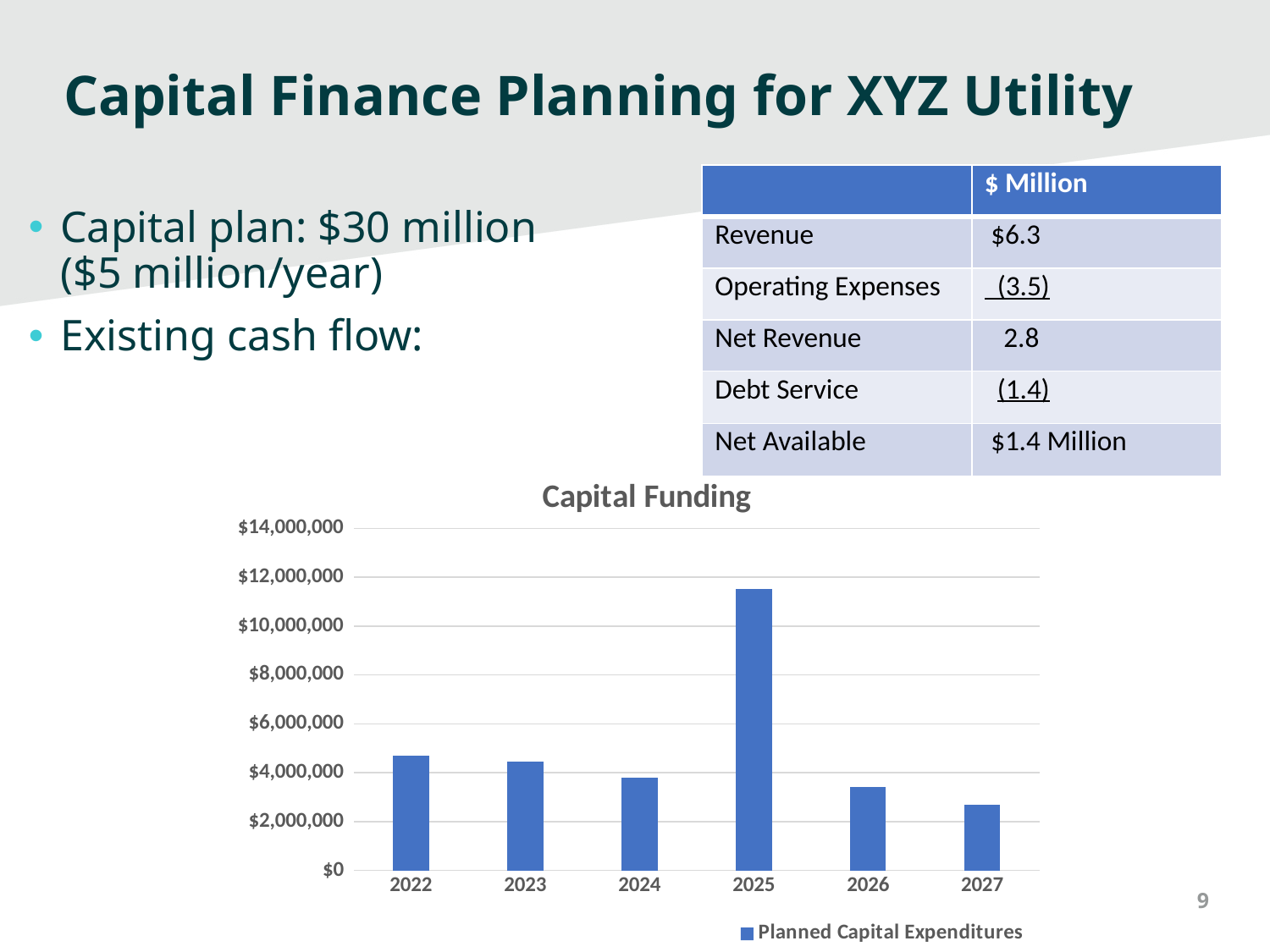
In the Capital Funding chart, is the value for 2022 greater or less than $4,000,000? greater In the Capital Funding chart, is the value for 2027 greater or less than $2,000,000? greater In the Capital Funding chart, do the values rise or fall from 2025 to 2027? fall In the Capital Funding chart, is the value for 2025 greater or less than $10,000,000? greater How many years are shown on the x axis of the Capital Funding chart? 6 In the Capital Funding chart, which year has the larger value, 2022 or 2027? 2022 What is the name of the series shown in the legend of the Capital Funding chart? Planned Capital Expenditures What kind of chart is the Capital Funding chart? bar chart How many series does the legend of the Capital Funding chart list? 1 Which year has the lowest planned capital expenditures in the Capital Funding chart? 2027 Which year has the highest planned capital expenditures in the Capital Funding chart? 2025